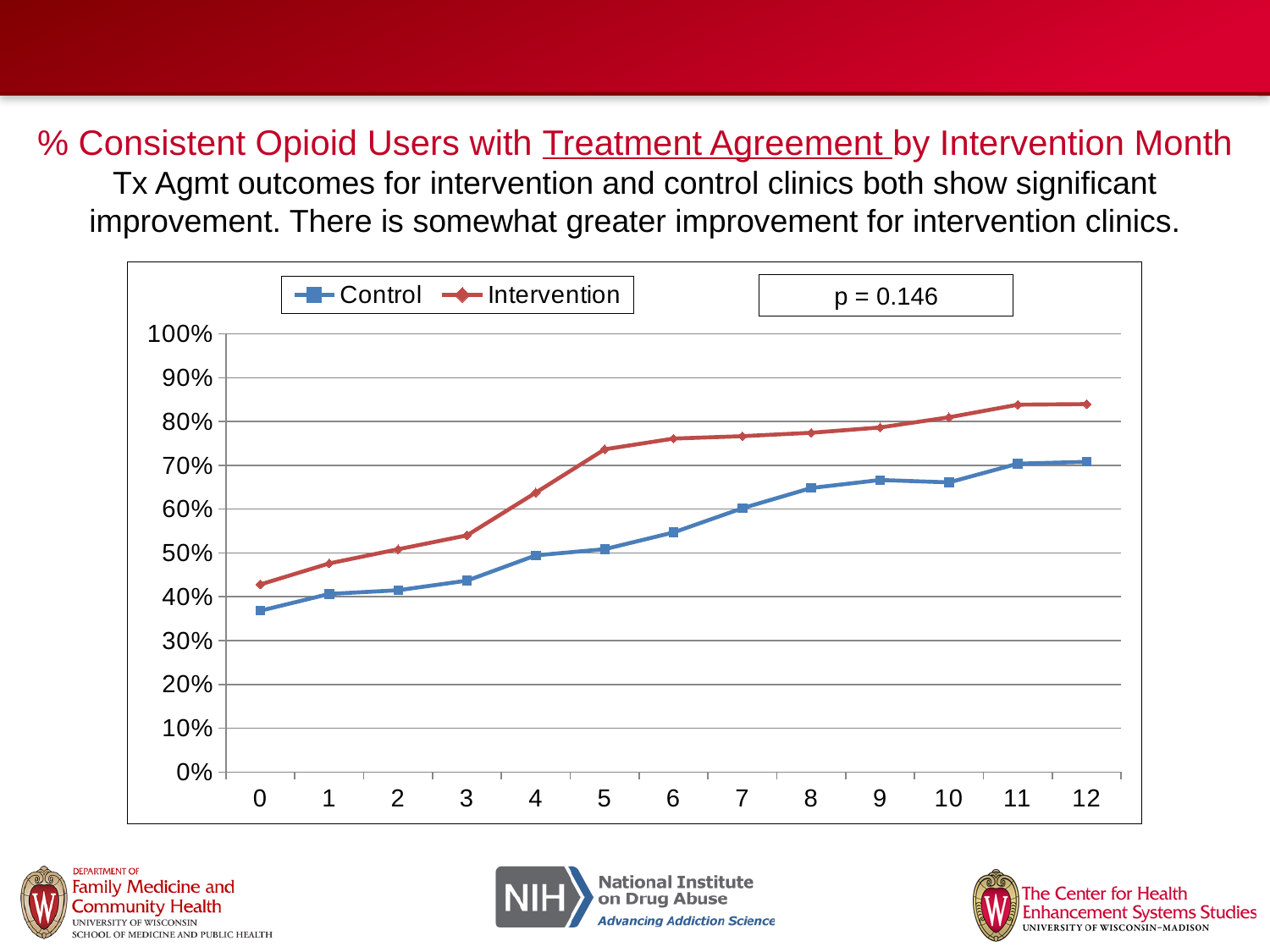
Is the Intervention value at month 12 greater or less than 80%? greater Is the Control value at month 0 greater or less than 40%? less Is the Intervention value at month 5 greater or less than 70%? greater Do the Control values generally rise or fall from month 0 to month 12? Rise What p-value is shown on the chart? p = 0.146 How many months (x-axis points) are plotted for each series? 13 What kind of chart is shown on the slide? Line chart How many series does the legend list? 2 At which month is the Control value lowest? 0 At month 4, which series has the higher value, Control or Intervention? Intervention